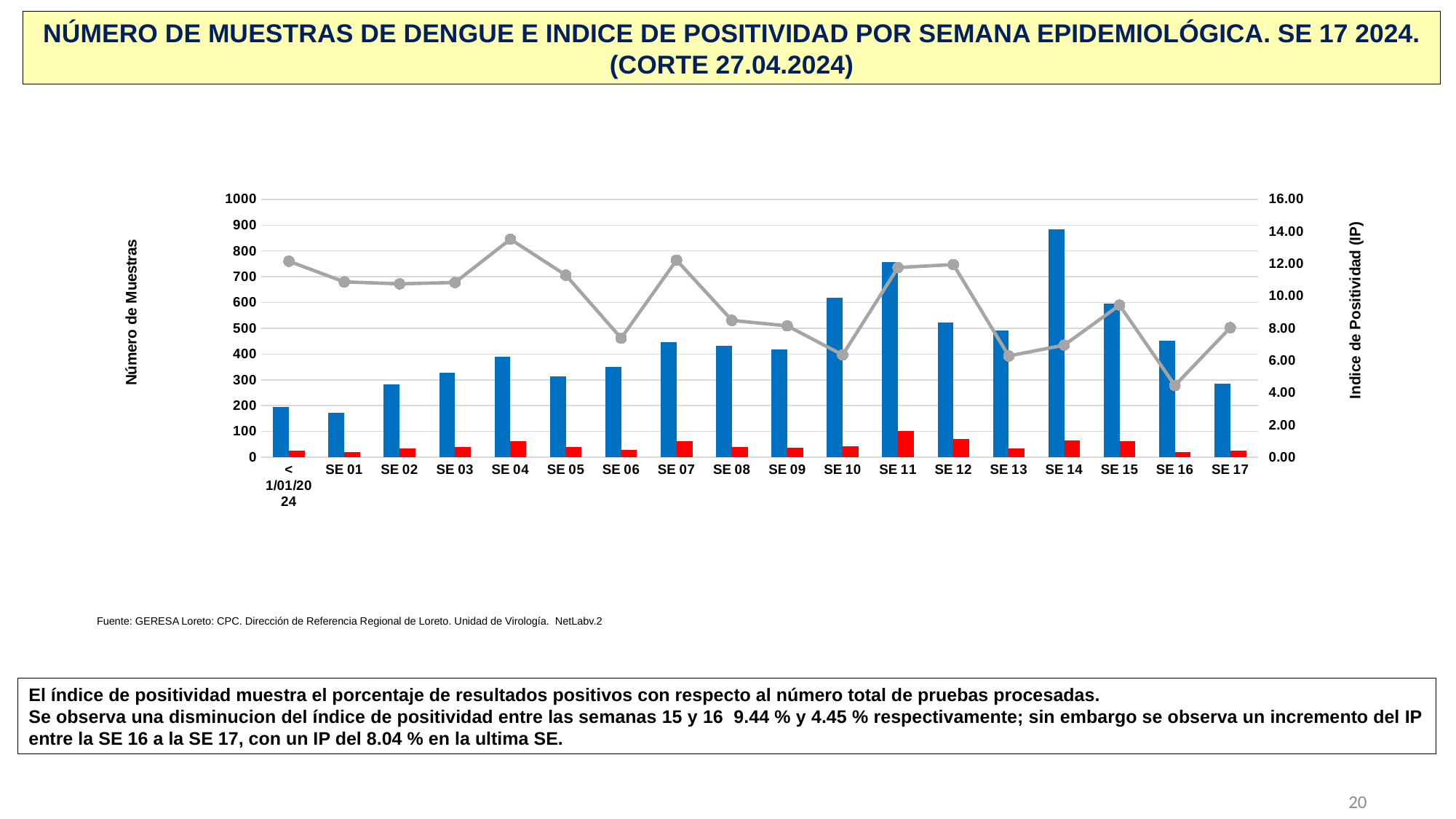
How many categories are shown along the x axis of the chart? 18 At which category does the grey line (Indice de Positividad) reach its lowest point? SE 16 Is the blue bar value for SE 01 greater or less than 200? less At which category does the grey line (Indice de Positividad) reach its highest point? SE 04 What kind of chart is shown on the slide? Combined bar and line chart Do the blue bars rise or fall from SE 01 to SE 04? rise Is the grey line value for SE 04 greater or less than 12.00 on the right axis? greater Which has the taller blue bar, SE 10 or SE 12? SE 10 Which category has the tallest red bar? SE 11 Which category has the tallest blue bar (Número de Muestras)? SE 14 Is the blue bar value for SE 14 greater or less than 800? greater Which category has the shortest blue bar (Número de Muestras)? SE 01